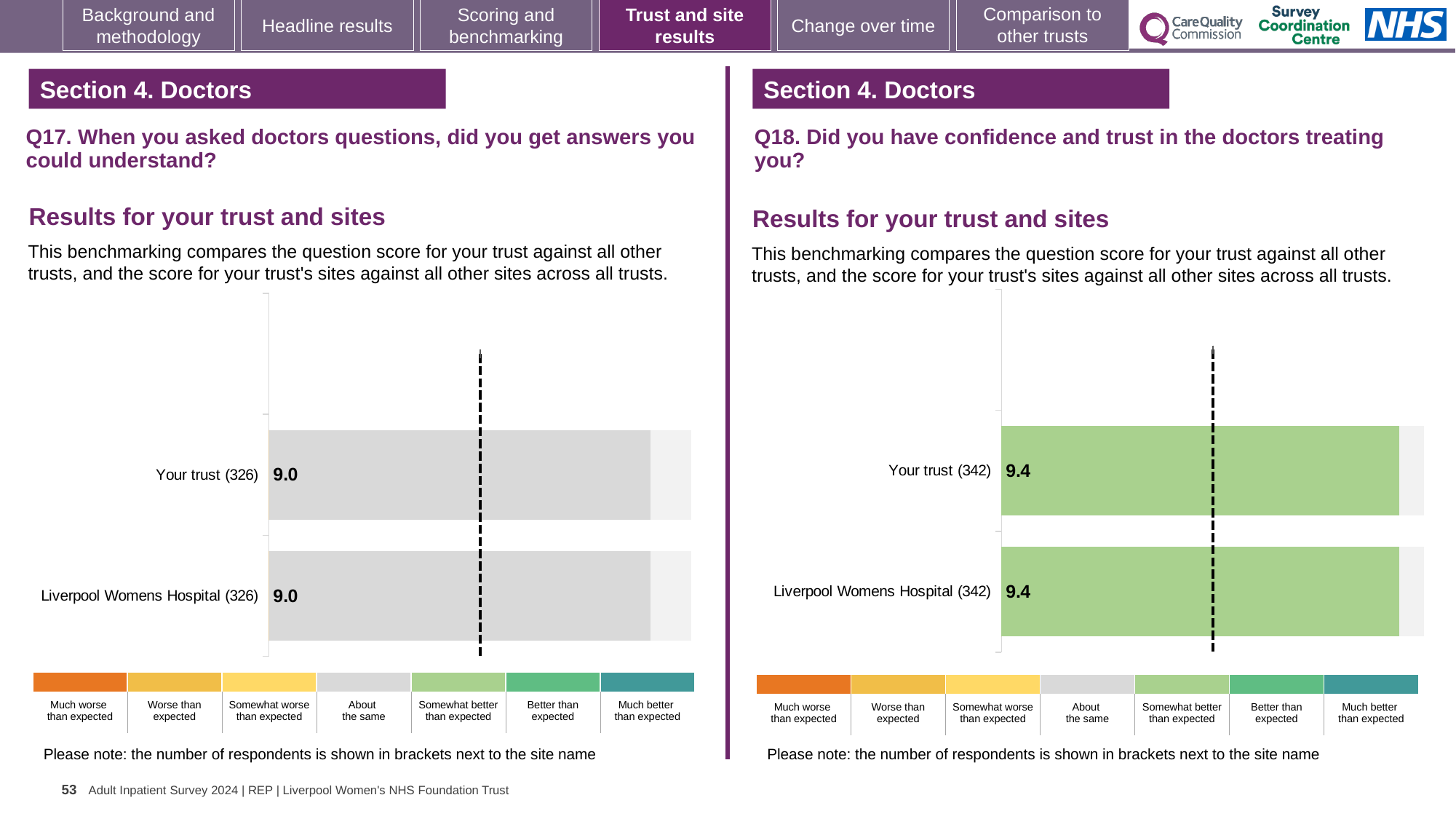
What type of chart is used in the Q18 chart on the right? Bar chart In the Q18 chart on the right, how many respondents are shown in brackets for Liverpool Womens Hospital? 342 In the Q17 chart on the left, how many respondents are shown in brackets for Your trust? 326 Is the Your trust score higher in the Q17 chart on the left or the Q18 chart on the right? Q18 chart on the right In the Q17 chart on the left, what is the score for Liverpool Womens Hospital? 9.0 In the Q18 chart on the right, what is the score for Liverpool Womens Hospital? 9.4 How many bars are plotted in the Q17 chart on the left? 2 In the Q17 chart on the left, what is the score for Your trust? 9.0 What is the difference between the Your trust score in the Q18 chart on the right and the Your trust score in the Q17 chart on the left? 0.4 In the Q17 chart on the left, which benchmark category does the colour of the bars correspond to according to the legend? About the same In the Q18 chart on the right, which benchmark category does the colour of the bars correspond to according to the legend? Somewhat better than expected In the Q18 chart on the right, what is the score for Your trust? 9.4